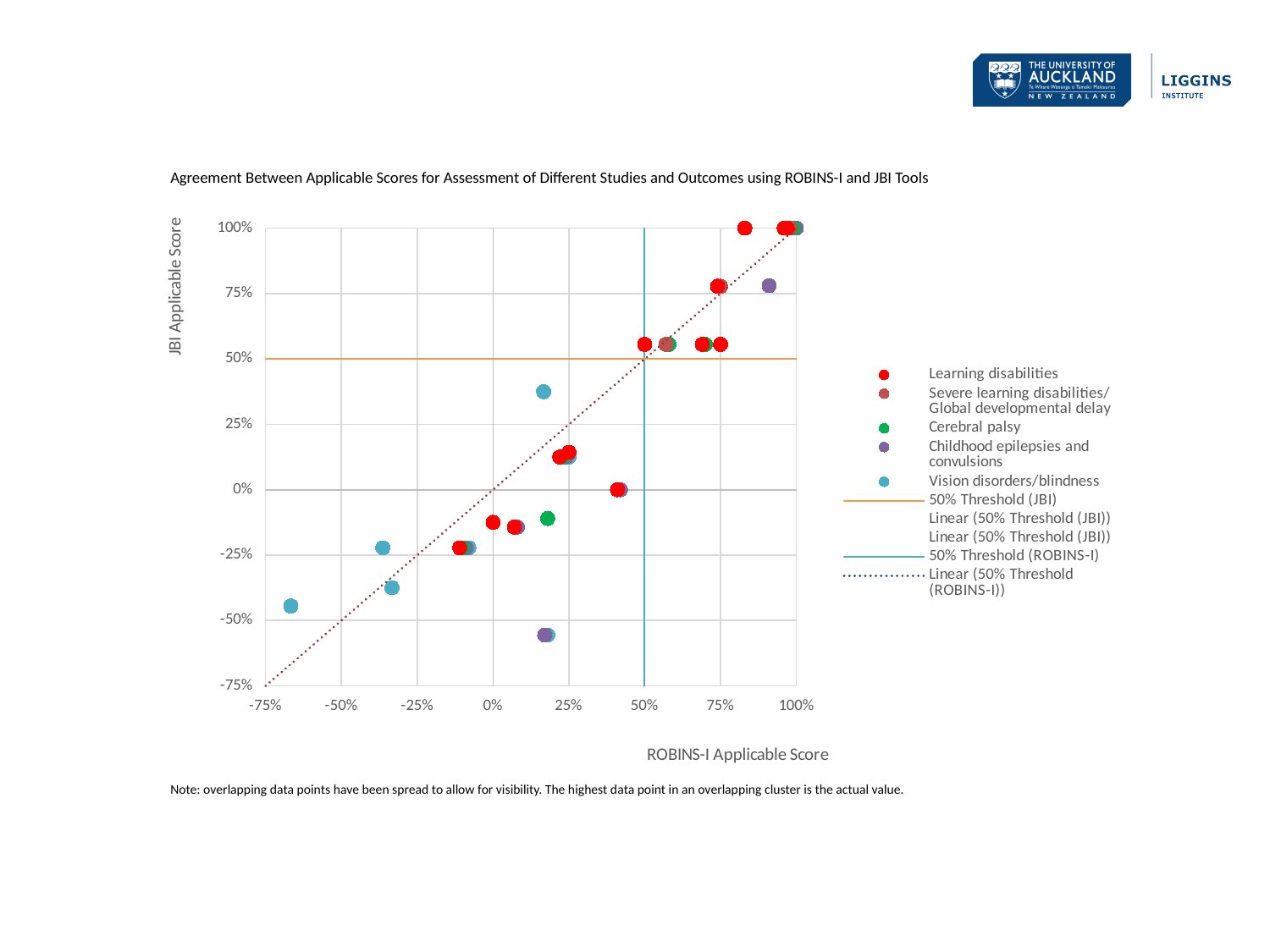
What is the title of the chart? Agreement Between Applicable Scores for Assessment of Different Studies and Outcomes using ROBINS-I and JBI Tools How many entries does the chart's legend list? 10 What kind of chart is shown on the slide? Scatter chart What is the label of the horizontal (x) axis? ROBINS-I Applicable Score At what ROBINS-I Applicable Score value is the blue '50% Threshold (ROBINS-I)' line drawn? 50% What is the lowest value shown on the vertical axis? -75% Is the JBI Applicable Score of the leftmost Vision disorders/blindness point (the one with the lowest ROBINS-I score) greater or less than -25%? less Which legend entry is represented by the green markers? Cerebral palsy What is the highest value shown on the horizontal axis? 100% Is the JBI Applicable Score of the Childhood epilepsies and convulsions point located to the right of the 75% ROBINS-I tick greater or less than 50%? greater What is the label of the vertical (y) axis? JBI Applicable Score At what JBI Applicable Score value is the orange '50% Threshold (JBI)' line drawn? 50%